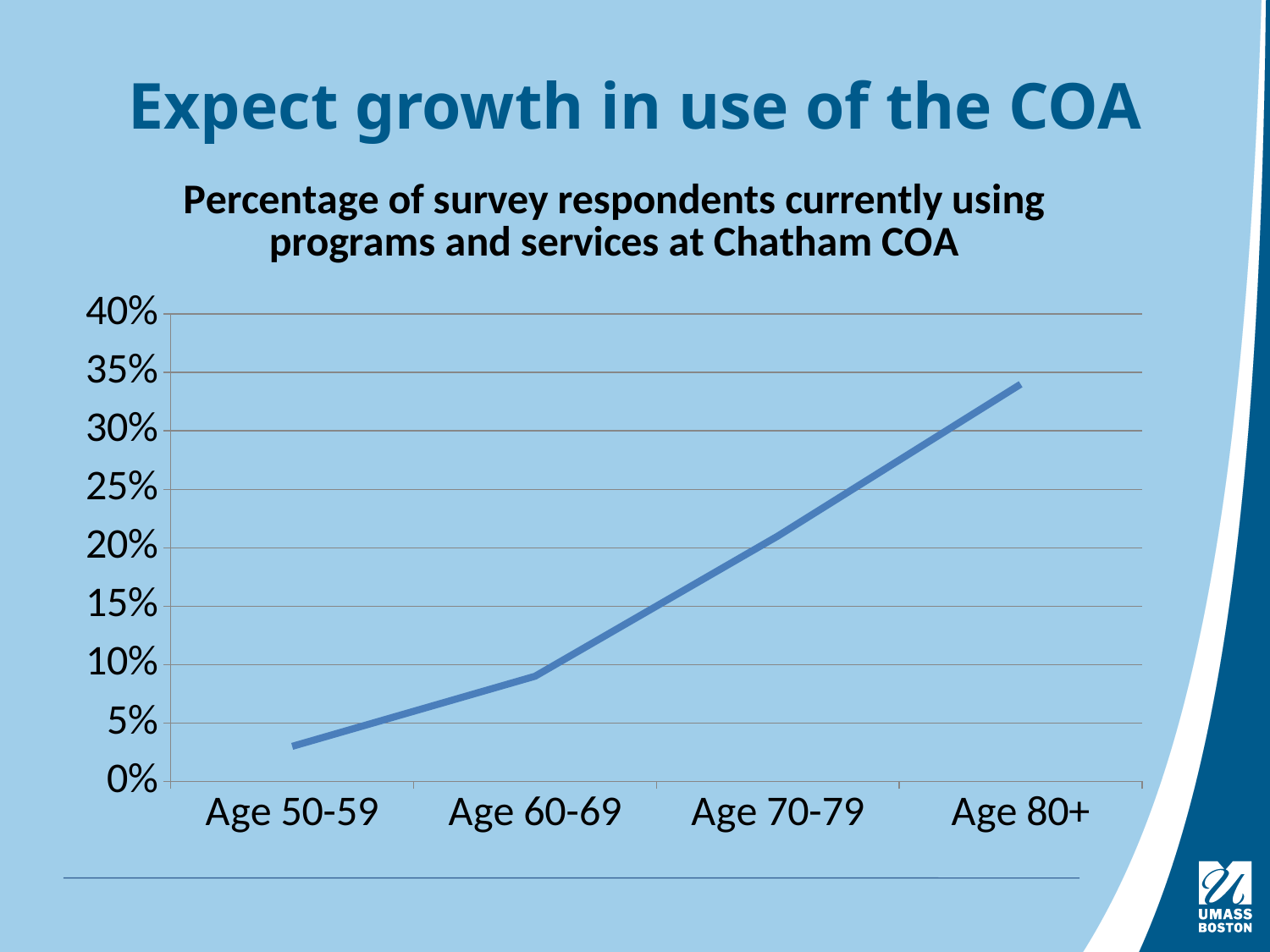
Is the value for Age 50-59 greater or less than 5%? less What kind of chart is shown on the slide? line chart How many age categories are plotted on the x axis? 4 What is the title of the chart? Percentage of survey respondents currently using programs and services at Chatham COA Is the value for Age 70-79 greater or less than 15%? greater Which age group has the highest percentage of respondents currently using programs and services at Chatham COA? Age 80+ Which age group has the lowest percentage of respondents currently using programs and services at Chatham COA? Age 50-59 What is the highest value shown on the y axis? 40% Is the value for Age 80+ greater or less than 30%? greater Which is larger, the value for Age 70-79 or the value for Age 60-69? Age 70-79 Do the values rise or fall as age increases along the x axis? rise